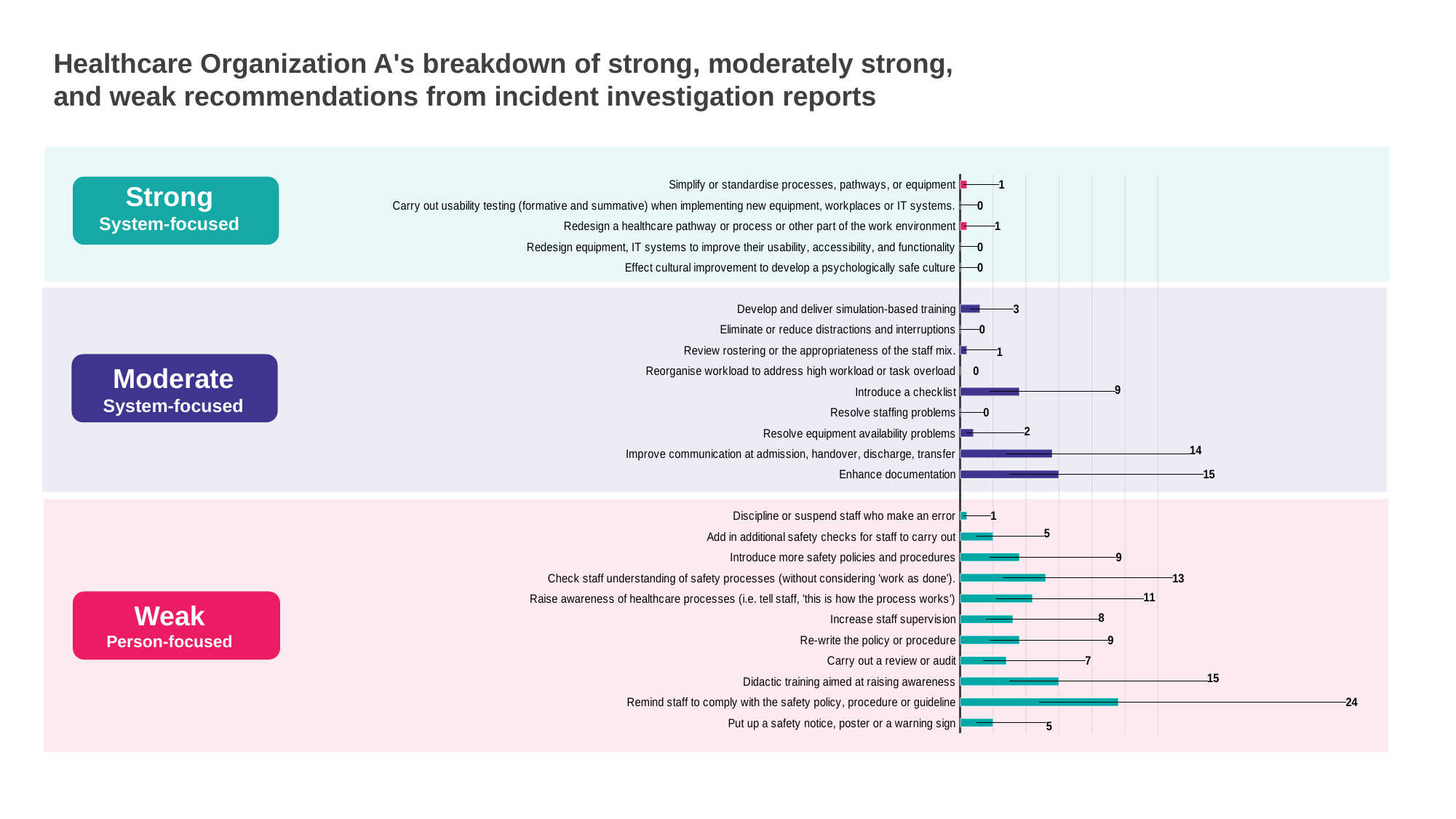
What kind of chart is shown on the slide? bar chart Which is larger: "Improve communication at admission, handover, discharge, transfer" or "Raise awareness of healthcare processes (i.e. tell staff, 'this is how the process works')"? Improve communication at admission, handover, discharge, transfer What is the value for "Remind staff to comply with the safety policy, procedure or guideline"? 24 What is the total of the values in the Strong (System-focused) group? 2 What is the value for "Enhance documentation"? 15 What is the difference between "Increase staff supervision" and "Carry out a review or audit"? 1 How many categories are plotted in the chart? 25 What is the value for "Introduce a checklist"? 9 What is the value for "Check staff understanding of safety processes (without considering 'work as done')"? 13 What are the three group labels shown to the left of the chart? Strong, Moderate, Weak What is the difference between "Remind staff to comply with the safety policy, procedure or guideline" and "Didactic training aimed at raising awareness"? 9 Which category has the highest value in the chart? Remind staff to comply with the safety policy, procedure or guideline